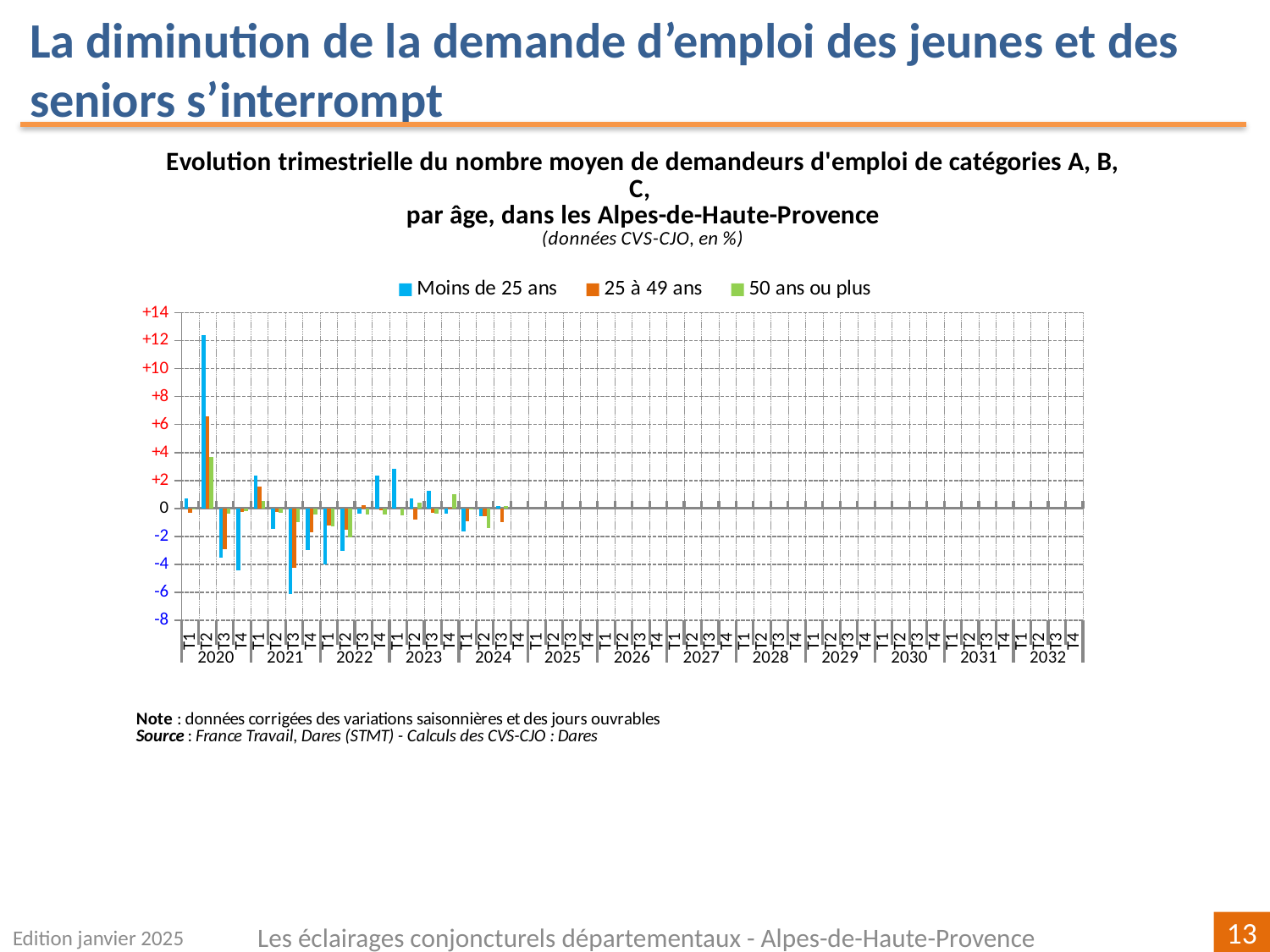
In T2 2020, which is larger: the value for Moins de 25 ans or the value for 25 à 49 ans? Moins de 25 ans Which quarter and series has the lowest bar on the chart? T3 2021, Moins de 25 ans Is the value for 25 à 49 ans in T2 2020 greater or less than +4? greater What kind of chart is shown on the slide? bar chart How many years are labelled along the x axis? 13 How many series does the legend list? 3 Which series is shown in green in the legend? 50 ans ou plus Which quarter and series has the highest bar on the chart? T2 2020, Moins de 25 ans Is the value for Moins de 25 ans in T2 2020 greater or less than +10? greater Is the value for Moins de 25 ans in T3 2021 greater or less than -4? less Which series is shown in blue in the legend? Moins de 25 ans